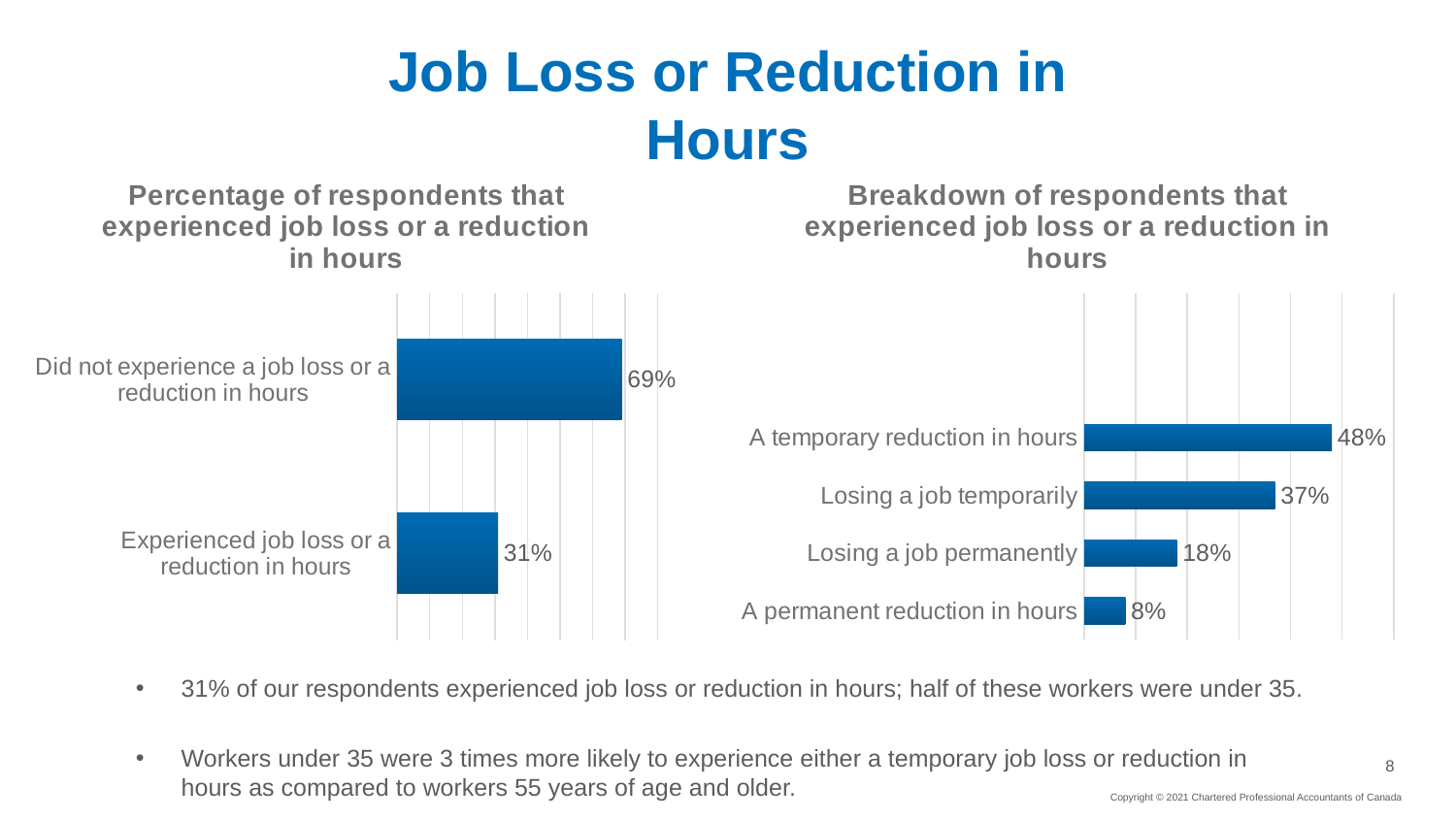
In the right chart, what is the difference between 'Losing a job temporarily' and 'Losing a job permanently'? 19% In the right chart, what is the value for 'Losing a job permanently'? 18% In the chart titled 'Breakdown of respondents that experienced job loss or a reduction in hours', what is the value for 'A temporary reduction in hours'? 48% In the right chart, which category has the lowest value? A permanent reduction in hours What kind of chart is the chart on the right of the slide? Bar chart In the right chart, which is larger: 'Losing a job temporarily' or 'A permanent reduction in hours'? Losing a job temporarily In the left chart, how many categories are plotted? 2 In the chart titled 'Percentage of respondents that experienced job loss or a reduction in hours', what is the value for 'Experienced job loss or a reduction in hours'? 31% In the left chart, what is the difference between the 'Did not experience' and 'Experienced' values? 38% In the right chart, how many categories are plotted? 4 In the chart titled 'Percentage of respondents that experienced job loss or a reduction in hours', what is the value for 'Did not experience a job loss or a reduction in hours'? 69% In the right chart, which category has the highest value? A temporary reduction in hours